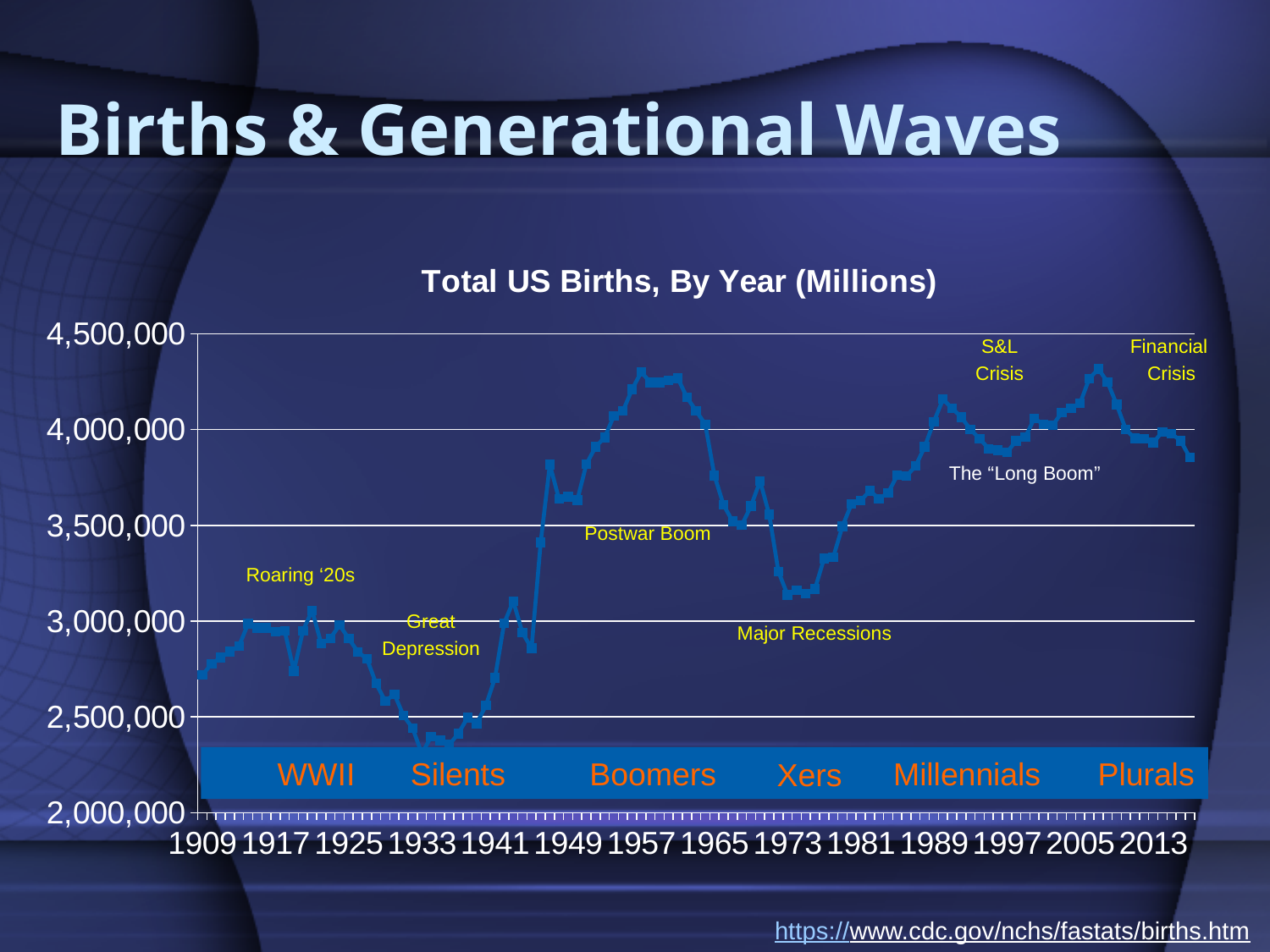
Is the value for 1973 greater or less than 3,500,000? less How many generation labels are shown in the band along the bottom of the chart? 6 Do the values rise or fall between 1957 and 1973? fall Is the value for 1957 greater or less than 4,000,000? greater Is the value for 1941 greater or less than 3,000,000? less Which year has the larger value, 1957 or 1973? 1957 What kind of chart is shown on the slide? line chart What is the title of the chart? Total US Births, By Year (Millions) Do the values rise or fall between 1933 and 1957? rise